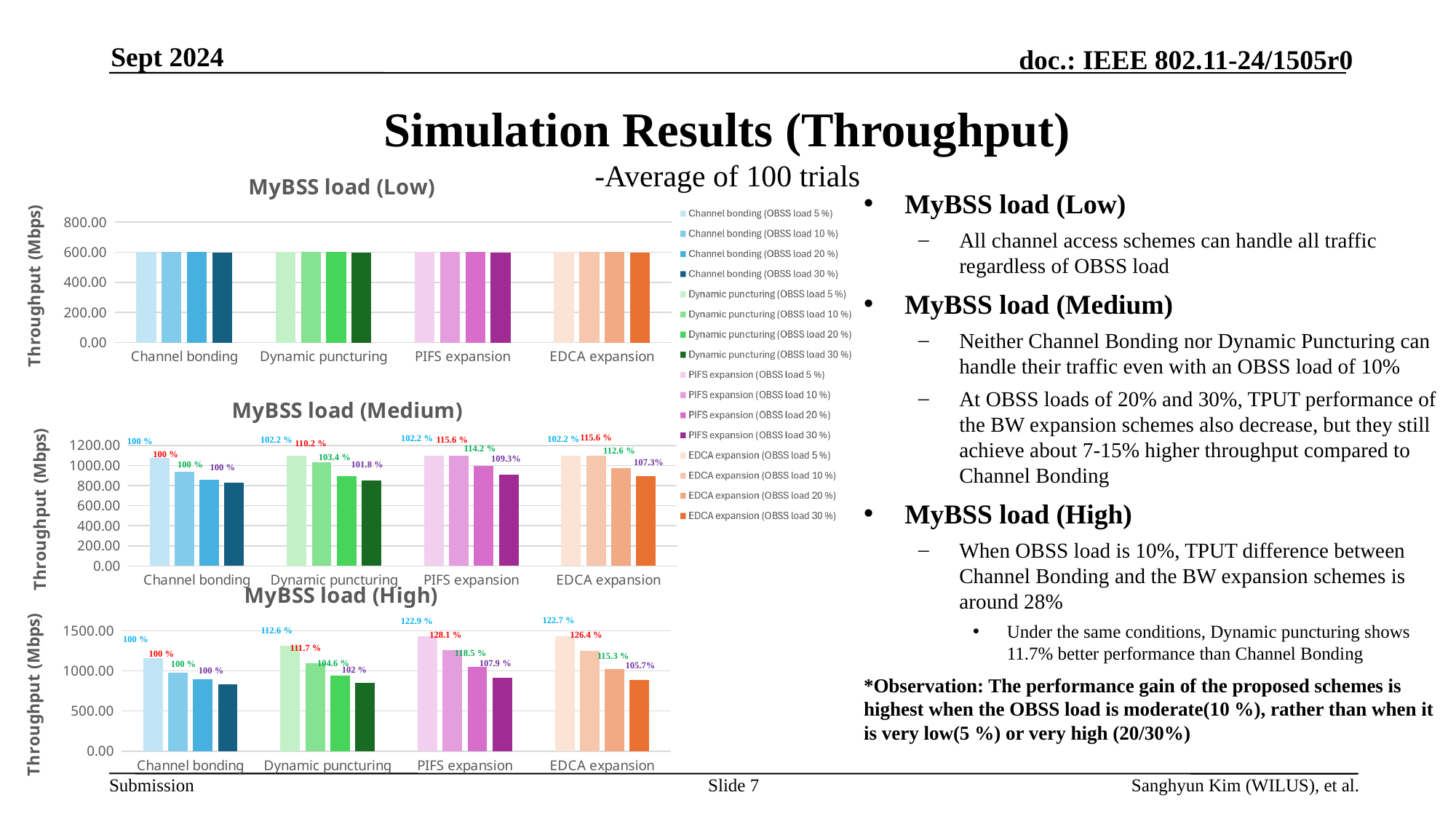
In the "MyBSS load (Medium)" chart, what percentage label is printed above the EDCA expansion (OBSS load 30 %) bar? 107.3% In the "MyBSS load (Medium)" chart, what percentage label is printed above the Dynamic puncturing (OBSS load 10 %) bar? 110.2 % In the "MyBSS load (High)" chart, what percentage label is printed above the PIFS expansion (OBSS load 10 %) bar? 128.1 % In the "MyBSS load (Medium)" chart, do the Channel bonding bars rise or fall as the OBSS load increases from 5 % to 30 %? fall How many series does the legend list for the charts? 16 How many categories are shown on the x axis of the "MyBSS load (Medium)" chart? 4 In the "MyBSS load (High)" chart, what percentage label is printed above the Dynamic puncturing (OBSS load 10 %) bar? 111.7 % In the "MyBSS load (High)" chart, which is larger: the Channel bonding (OBSS load 5 %) bar or the Dynamic puncturing (OBSS load 5 %) bar? Dynamic puncturing (OBSS load 5 %) In the "MyBSS load (Low)" chart, is the value for Channel bonding (OBSS load 5 %) greater or less than 400.00? greater In the "MyBSS load (Medium)" chart, is the value for Channel bonding (OBSS load 30 %) greater or less than 1000.00? less What is the y-axis title of the "MyBSS load (High)" chart? Throughput (Mbps) What kind of chart is the "MyBSS load (Low)" chart? bar chart